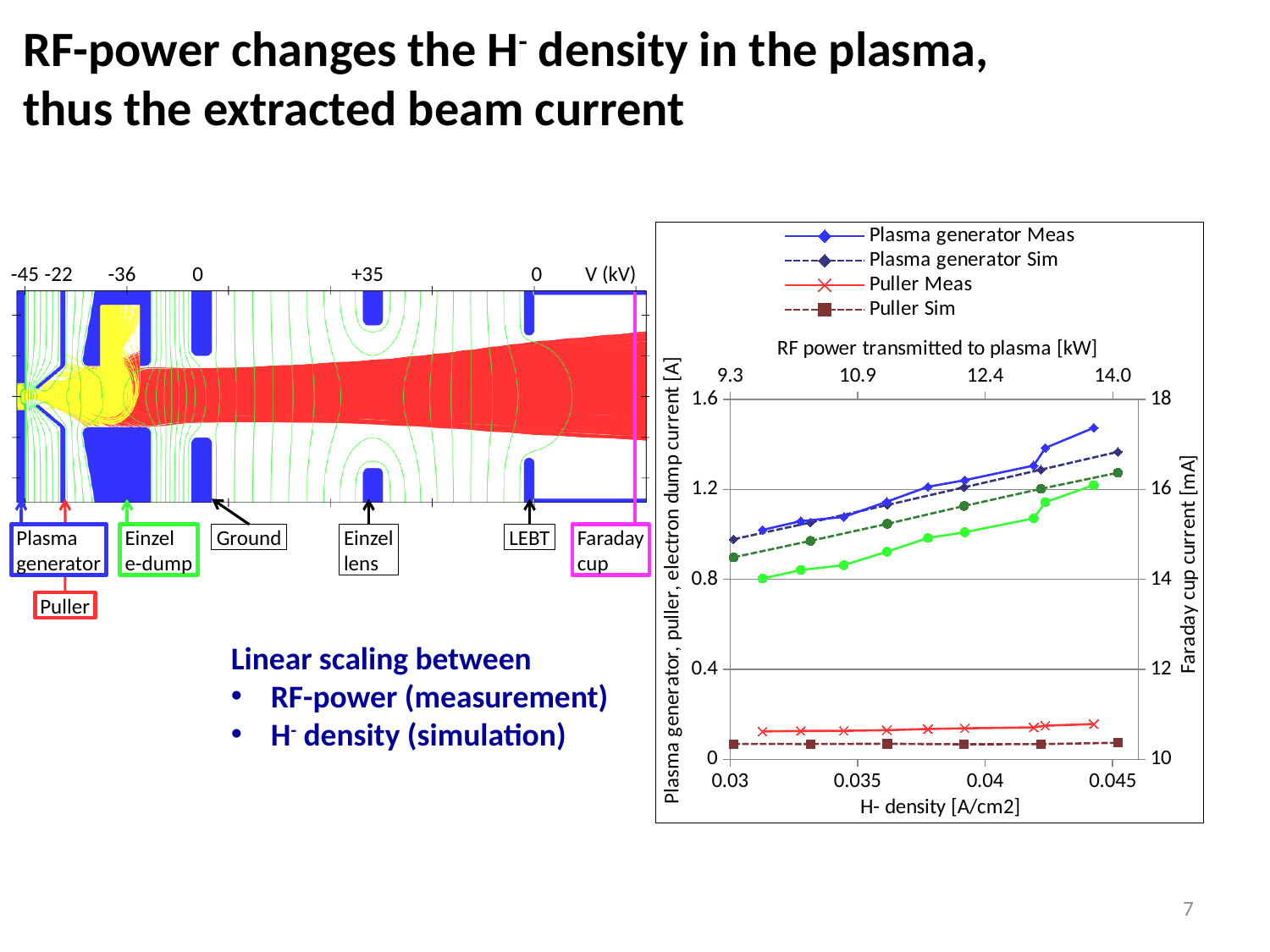
Are the values of the Puller Sim series greater or less than 0.4? less Does the Plasma generator Sim series rise or fall along the x axis? rise What is the title of the top x axis of the chart? RF power transmitted to plasma [kW] Which series has larger values, Plasma generator Meas or Puller Meas? Plasma generator Meas Is the value of Plasma generator Meas at H- density 0.03 greater or less than 1.2? less Is the highest value of the Plasma generator Meas series greater or less than 1.2? greater Does the Plasma generator Meas series rise or fall as H- density increases? rise What is the title of the bottom x axis of the chart? H- density [A/cm2] What kind of chart is shown on the slide? line chart How many series does the chart legend list? 4